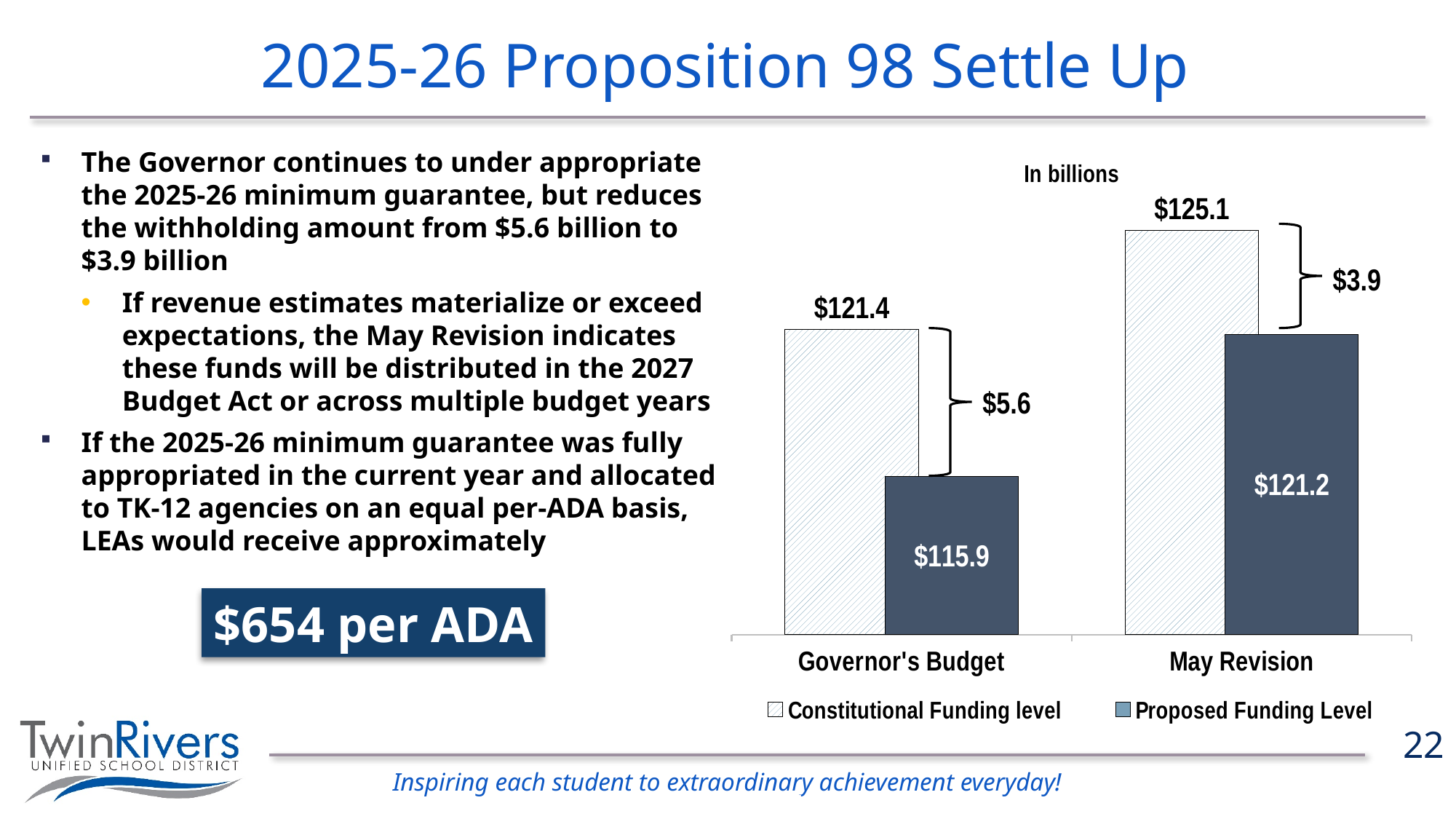
What is the Constitutional Funding level for the Governor's Budget? $121.4 What is the difference between the Constitutional Funding level and the Proposed Funding Level for the Governor's Budget? $5.6 What is the Proposed Funding Level for the Governor's Budget? $115.9 What is the Constitutional Funding level for the May Revision? $125.1 What kind of chart is shown on the slide? Bar chart What is the difference between the Constitutional Funding level and the Proposed Funding Level for the May Revision? $3.9 Which category has the highest Constitutional Funding level? May Revision How many categories are shown on the x axis of the chart? 2 What is the Proposed Funding Level for the May Revision? $121.2 Is the Proposed Funding Level higher for the Governor's Budget or the May Revision? May Revision How many series does the chart legend list? 2 Which category has the lowest Proposed Funding Level? Governor's Budget